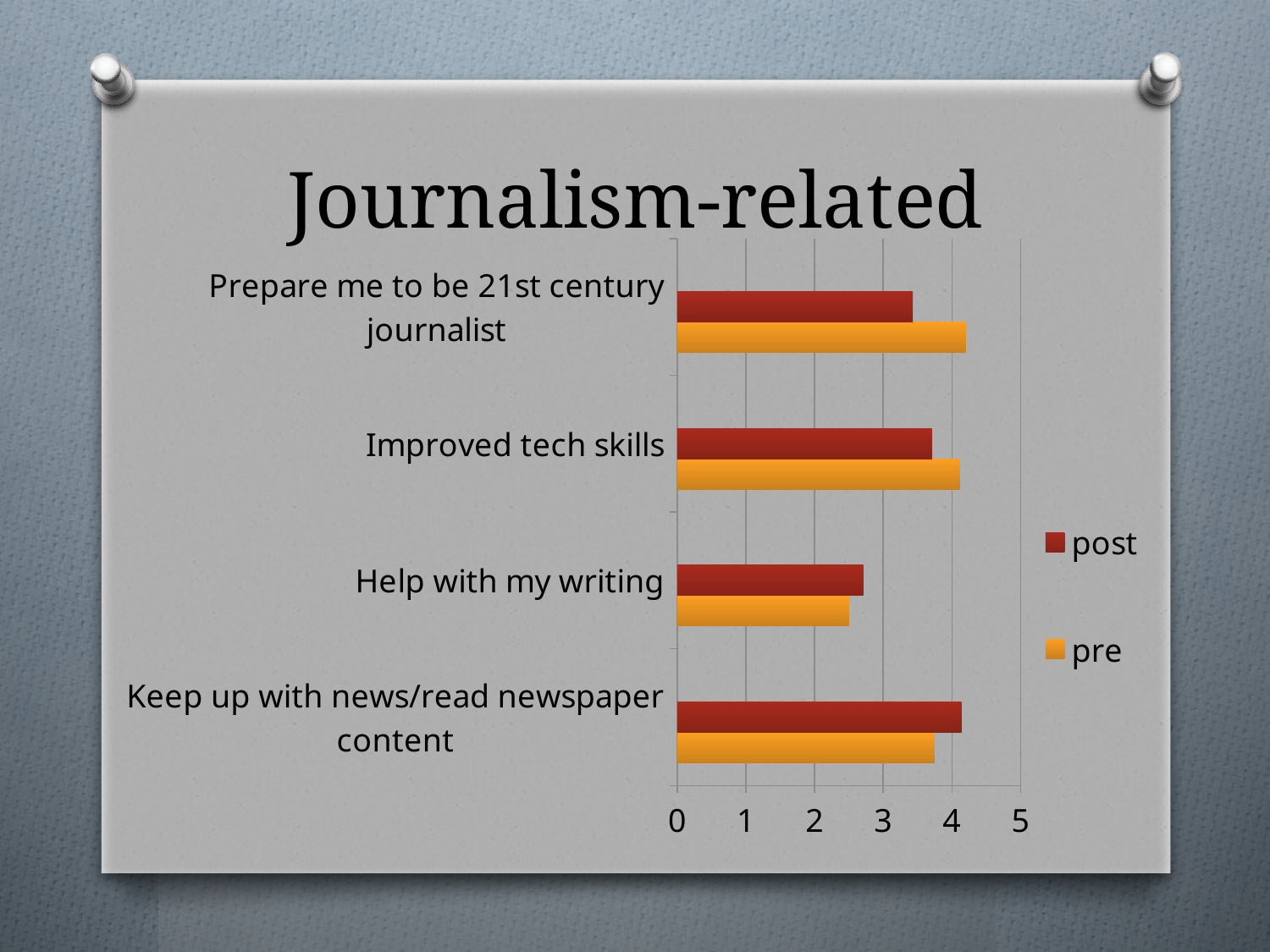
Is the post value for "Keep up with news/read newspaper content" greater or less than 4? greater What kind of chart is shown on the slide? bar chart For "Prepare me to be 21st century journalist", which is larger, the pre value or the post value? pre Is the pre value for "Prepare me to be 21st century journalist" greater or less than 4? greater How many series does the legend list? 2 For "Keep up with news/read newspaper content", which is larger, the pre value or the post value? post What is the title of the chart? Journalism-related Is the post value for "Help with my writing" greater or less than 3? less What are the two series named in the legend? post and pre How many categories are shown on the chart? 4 Which category has the lowest pre value? Help with my writing